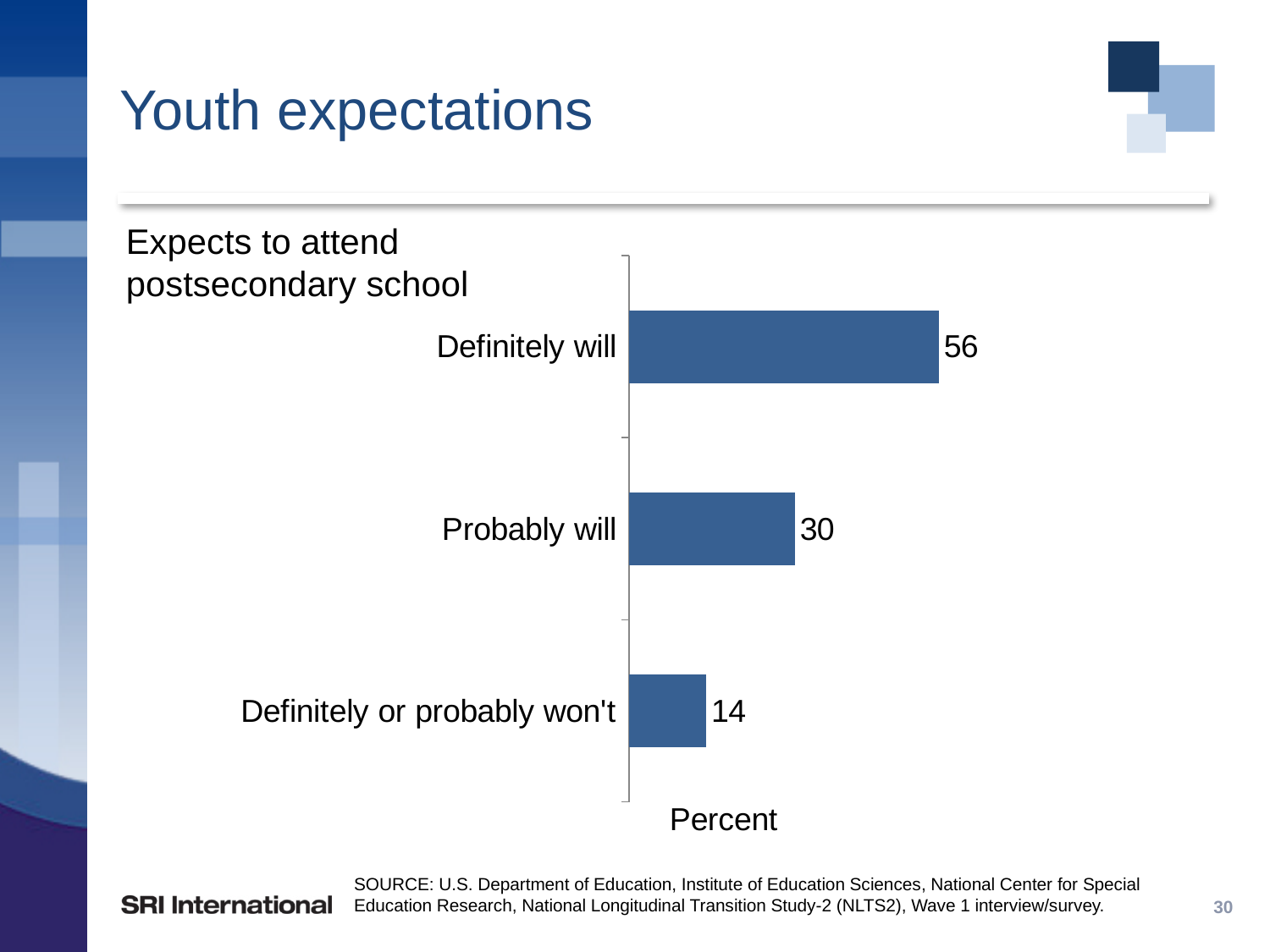
What kind of chart is shown on the slide? Bar chart What percent of youth say they probably will attend postsecondary school? 30 What percent of youth say they definitely will attend postsecondary school? 56 Which is larger, the percent for 'Probably will' or for 'Definitely or probably won't'? Probably will Which expectation category has the highest percent? Definitely will What is the difference in percent between 'Probably will' and 'Definitely or probably won't'? 16 How many expectation categories are shown in the chart? 3 What percent of youth say they definitely or probably won't attend postsecondary school? 14 Which expectation category has the lowest percent? Definitely or probably won't What is the label on the horizontal axis of the chart? Percent What is the title of the chart? Expects to attend postsecondary school What is the difference in percent between 'Definitely will' and 'Probably will'? 26